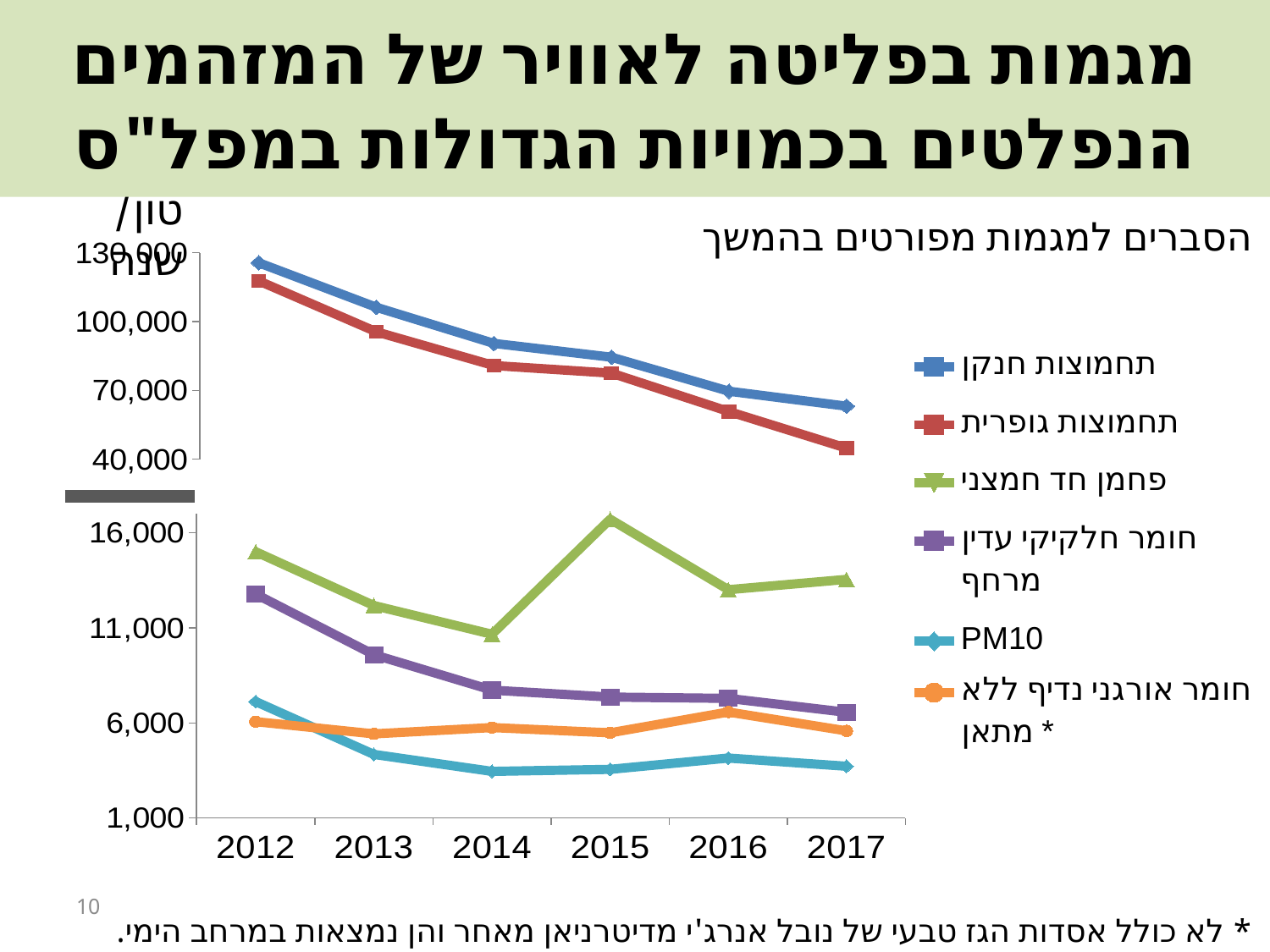
Is the value for תחמוצות חנקן in 2012 greater or less than 100,000? greater Is the value for PM10 in 2014 greater or less than 6,000? less Does the value for תחמוצות חנקן rise or fall from 2012 to 2017? fall How many years are shown along the x axis? 6 What unit is shown at the top of the y axis? טון/שנה Which series has the lowest value in 2017? PM10 How many series does the legend list? 6 What kind of chart is shown on the slide? line chart Which series has the highest value in 2012? תחמוצות חנקן In which year does פחמן חד חמצני reach its highest value? 2015 In 2017, which is larger: תחמוצות חנקן or תחמוצות גופרית? תחמוצות חנקן Is the value for תחמוצות גופרית in 2017 greater or less than 70,000? less